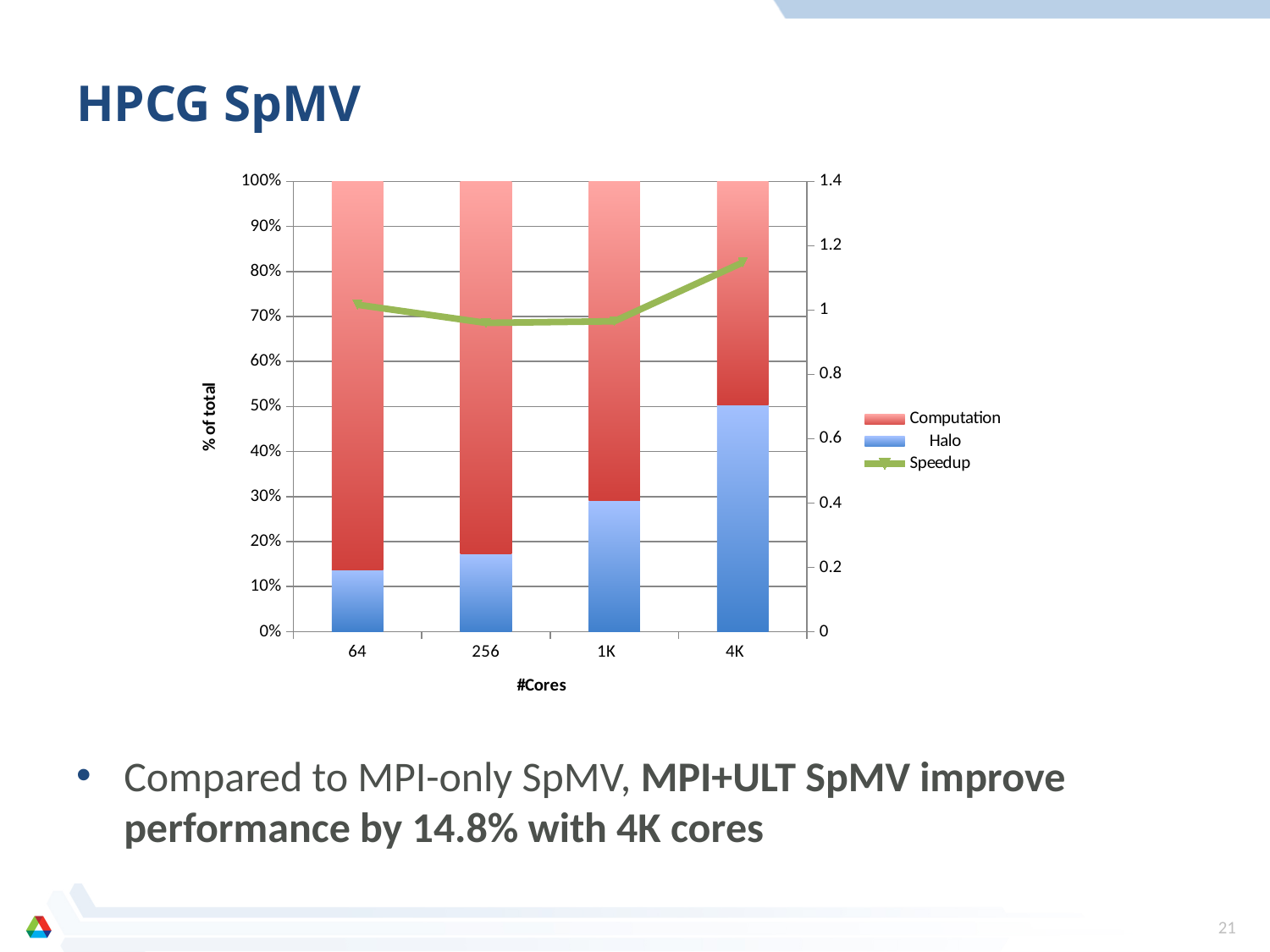
Which has a larger Computation share, 256 cores or 4K cores? 256 Which core count has the largest Halo share? 4K What is the label of the left vertical axis? % of total Is the Speedup value for 4K cores greater or less than 1? greater Which core count has the smallest Halo share? 64 What kind of chart is shown on the slide? stacked bar chart with a line Is the Halo share for 1K cores greater or less than 20%? greater Is the Halo share for 64 cores greater or less than 20%? less How many series does the legend list? 3 Does the Halo share rise or fall as the number of cores increases? rise How many core counts are shown on the x axis? 4 What is the label of the x axis? #Cores